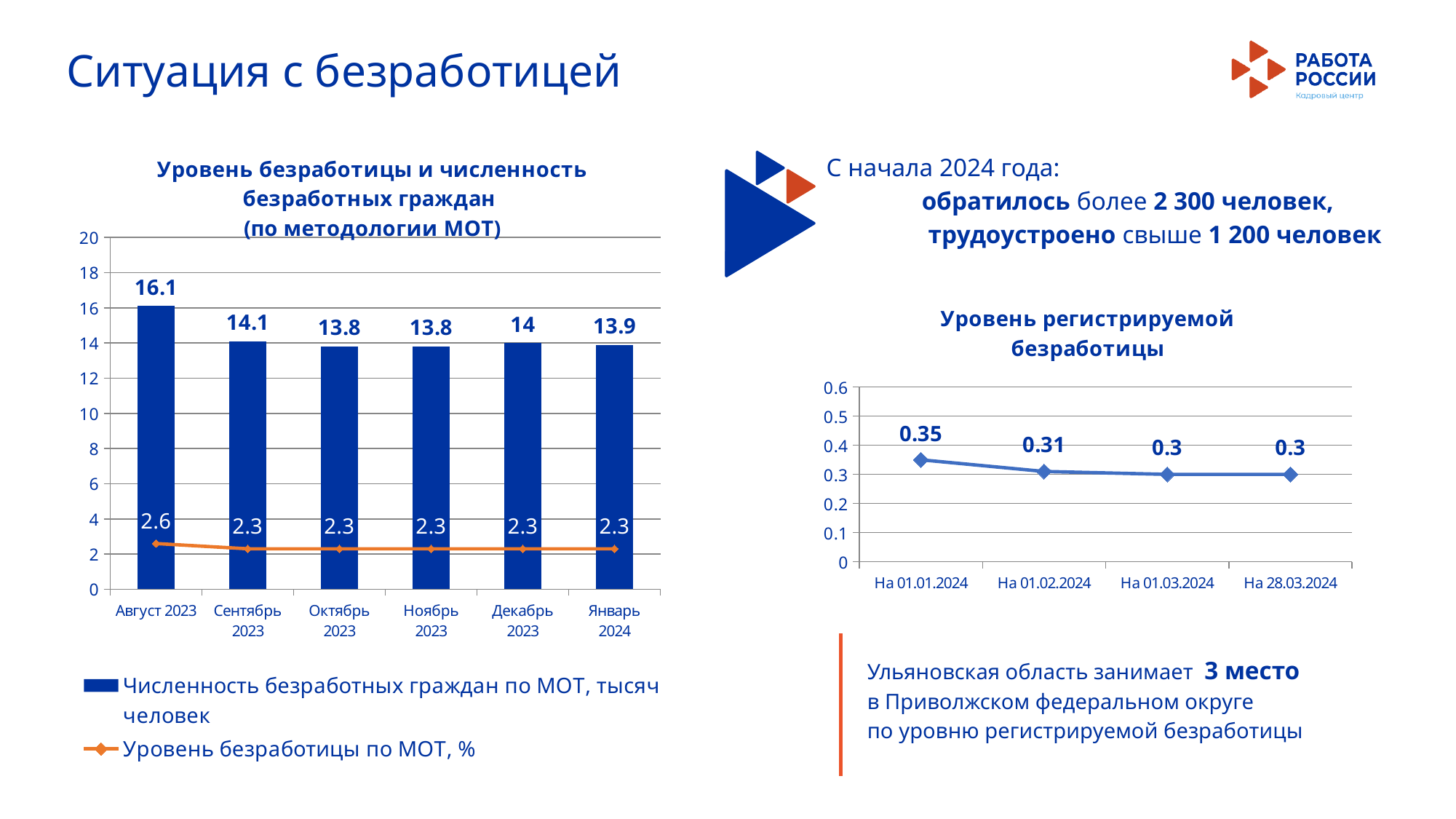
In the right chart 'Уровень регистрируемой безработицы', which date has the highest value? На 01.01.2024 In the right chart 'Уровень регистрируемой безработицы', do the values rise or fall from На 01.01.2024 to На 01.03.2024? fall In the left chart 'Уровень безработицы и численность безработных граждан (по методологии МОТ)', which month has the highest value of 'Численность безработных граждан по МОТ, тысяч человек'? Август 2023 In the left chart 'Уровень безработицы и численность безработных граждан (по методологии МОТ)', what is the value of 'Уровень безработицы по МОТ, %' for Август 2023? 2.6 In the left chart 'Уровень безработицы и численность безработных граждан (по методологии МОТ)', what is the value of 'Численность безработных граждан по МОТ, тысяч человек' for Август 2023? 16.1 What kind of chart is the right chart 'Уровень регистрируемой безработицы'? line chart In the left chart 'Уровень безработицы и численность безработных граждан (по методологии МОТ)', how many series does the legend list? 2 In the left chart 'Уровень безработицы и численность безработных граждан (по методологии МОТ)', what is the difference between the 'Численность безработных граждан по МОТ' values for Август 2023 and Сентябрь 2023? 2 In the right chart 'Уровень регистрируемой безработицы', what is the value for На 01.02.2024? 0.31 In the left chart 'Уровень безработицы и численность безработных граждан (по методологии МОТ)', is the 'Численность безработных граждан по МОТ' value for Декабрь 2023 larger or smaller than for Январь 2024? larger In the left chart 'Уровень безработицы и численность безработных граждан (по методологии МОТ)', how many months are shown on the x axis? 6 In the right chart 'Уровень регистрируемой безработицы', what is the difference between the values for На 01.01.2024 and На 28.03.2024? 0.05